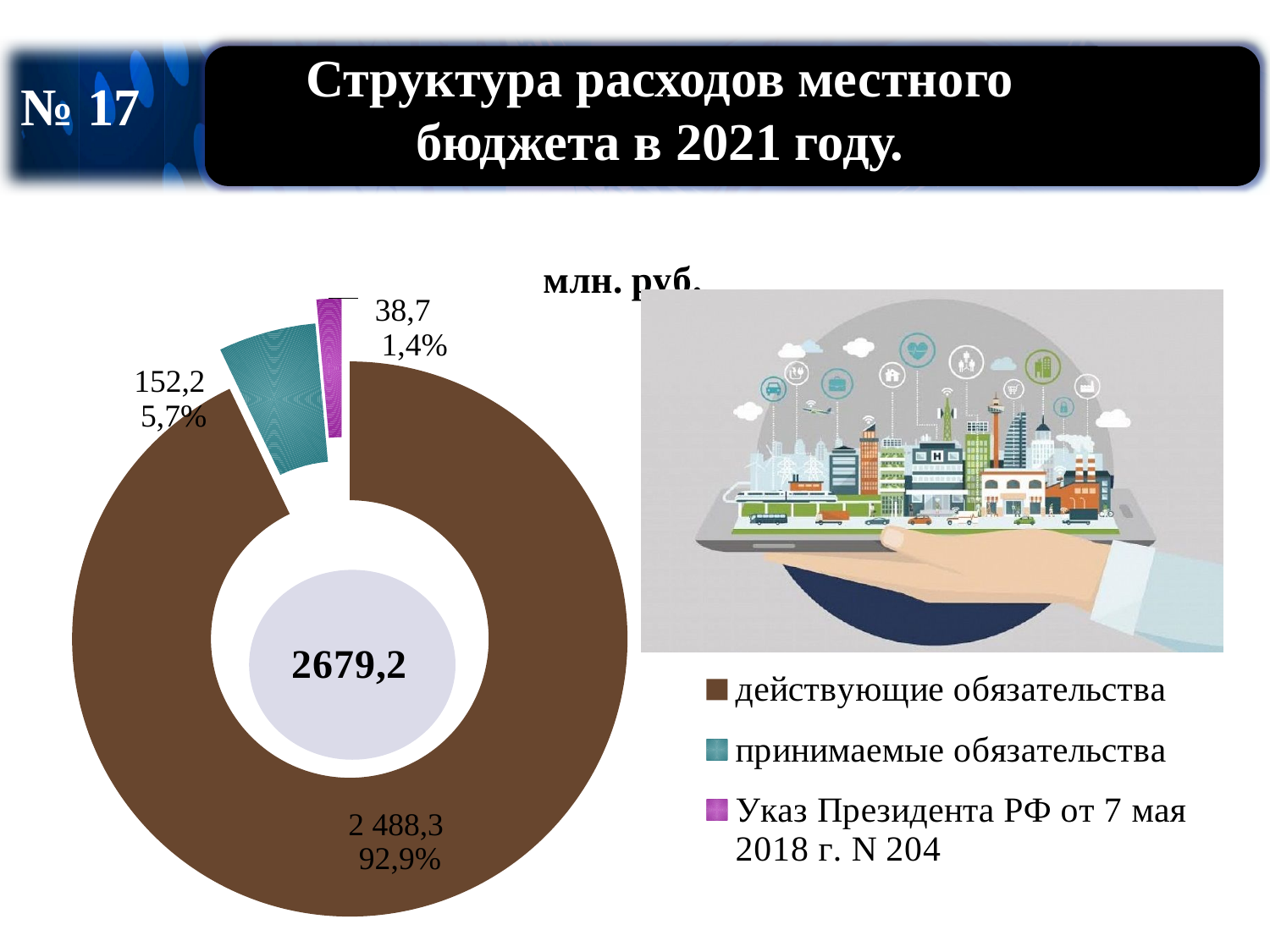
What is the value for действующие обязательства? 2 488,3 What is the difference between the values for принимаемые обязательства and Указ Президента РФ от 7 мая 2018 г. N 204? 113,5 How many categories does the legend list? 3 What share of the chart does действующие обязательства take? 92,9% Which category has the largest value? действующие обязательства What share of the chart does Указ Президента РФ от 7 мая 2018 г. N 204 take? 1,4% What total value is shown in the centre of the chart? 2679,2 What is the value for Указ Президента РФ от 7 мая 2018 г. N 204? 38,7 What share of the chart does принимаемые обязательства take? 5,7% Which category has the smallest value? Указ Президента РФ от 7 мая 2018 г. N 204 What kind of chart is shown on the slide? doughnut (pie) chart What is the value for принимаемые обязательства? 152,2